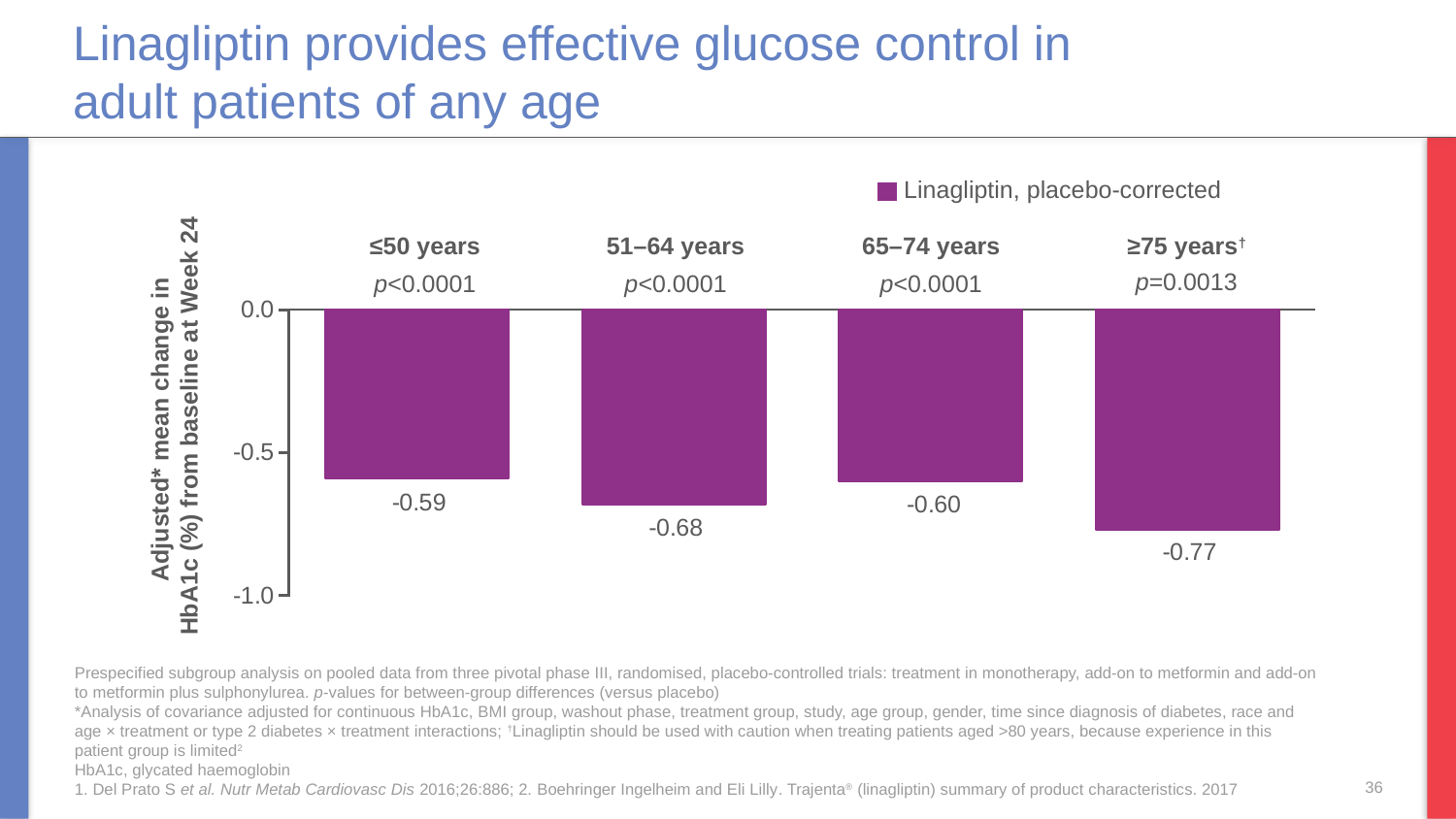
What is the p-value shown for the ≥75 years group? p=0.0013 What is the adjusted mean change in HbA1c for the ≤50 years group? -0.59 What is the adjusted mean change in HbA1c for the 65–74 years group? -0.60 What is the adjusted mean change in HbA1c for the 51–64 years group? -0.68 Which age group shows the largest reduction in HbA1c (the most negative value)? ≥75 years How many age groups are shown in the chart? 4 What type of chart is shown on the slide? Bar chart What is the difference between the HbA1c change for the ≥75 years group and the ≤50 years group? 0.18 Which group has a larger reduction in HbA1c: 51–64 years or 65–74 years? 51–64 years What is the adjusted mean change in HbA1c for the ≥75 years group? -0.77 Is the value for the ≥75 years group greater or less than -0.5? less Which age group shows the smallest reduction in HbA1c (the least negative value)? ≤50 years